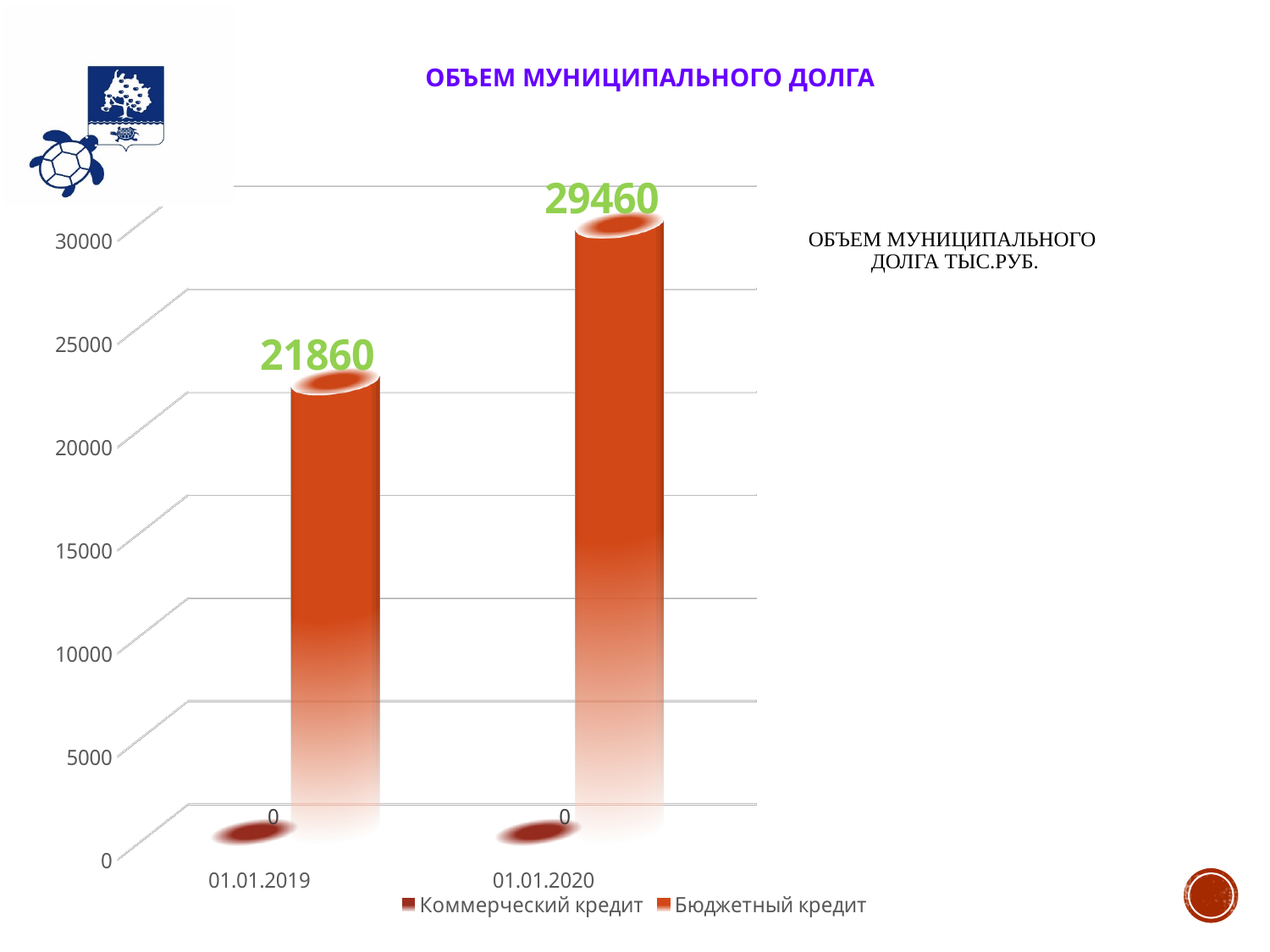
What kind of chart is shown? bar chart Which is larger: Бюджетный кредит on 01.01.2019 or on 01.01.2020? 01.01.2020 How many series does the legend list? 2 How many dates are shown on the x axis? 2 On which date is Бюджетный кредит highest? 01.01.2020 On which date is Бюджетный кредит lowest? 01.01.2019 What is the value of Коммерческий кредит on 01.01.2020? 0 Does Бюджетный кредит rise or fall from 01.01.2019 to 01.01.2020? rise By how much did Бюджетный кредит increase from 01.01.2019 to 01.01.2020? 7600 What is the value of Коммерческий кредит on 01.01.2019? 0 What is the value of Бюджетный кредит on 01.01.2019? 21860 What is the value of Бюджетный кредит on 01.01.2020? 29460